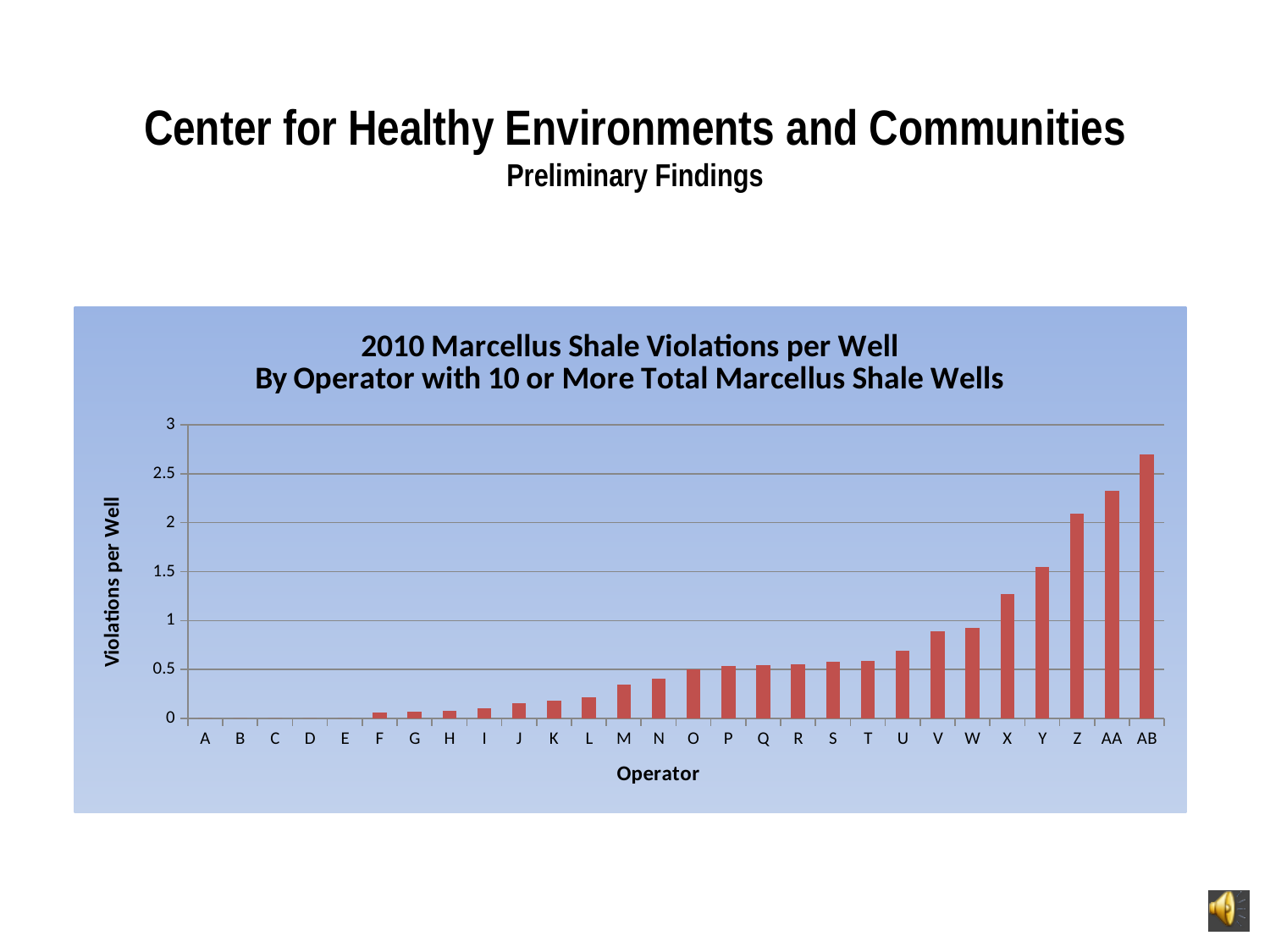
What is the label on the y axis of the chart? Violations per Well Is the value for operator V greater or less than 1? less Is the value for operator AB greater or less than 2.5? greater How many operators are shown along the x axis of the chart? 28 Is the value for operator M greater or less than 0.5? less Which operator has the highest violations per well? AB Which operator has more violations per well, AB or AA? AB What kind of chart is shown on the slide? bar chart Which operator has more violations per well, X or V? X Do the values generally rise or fall moving from operator A to operator AB along the x axis? rise